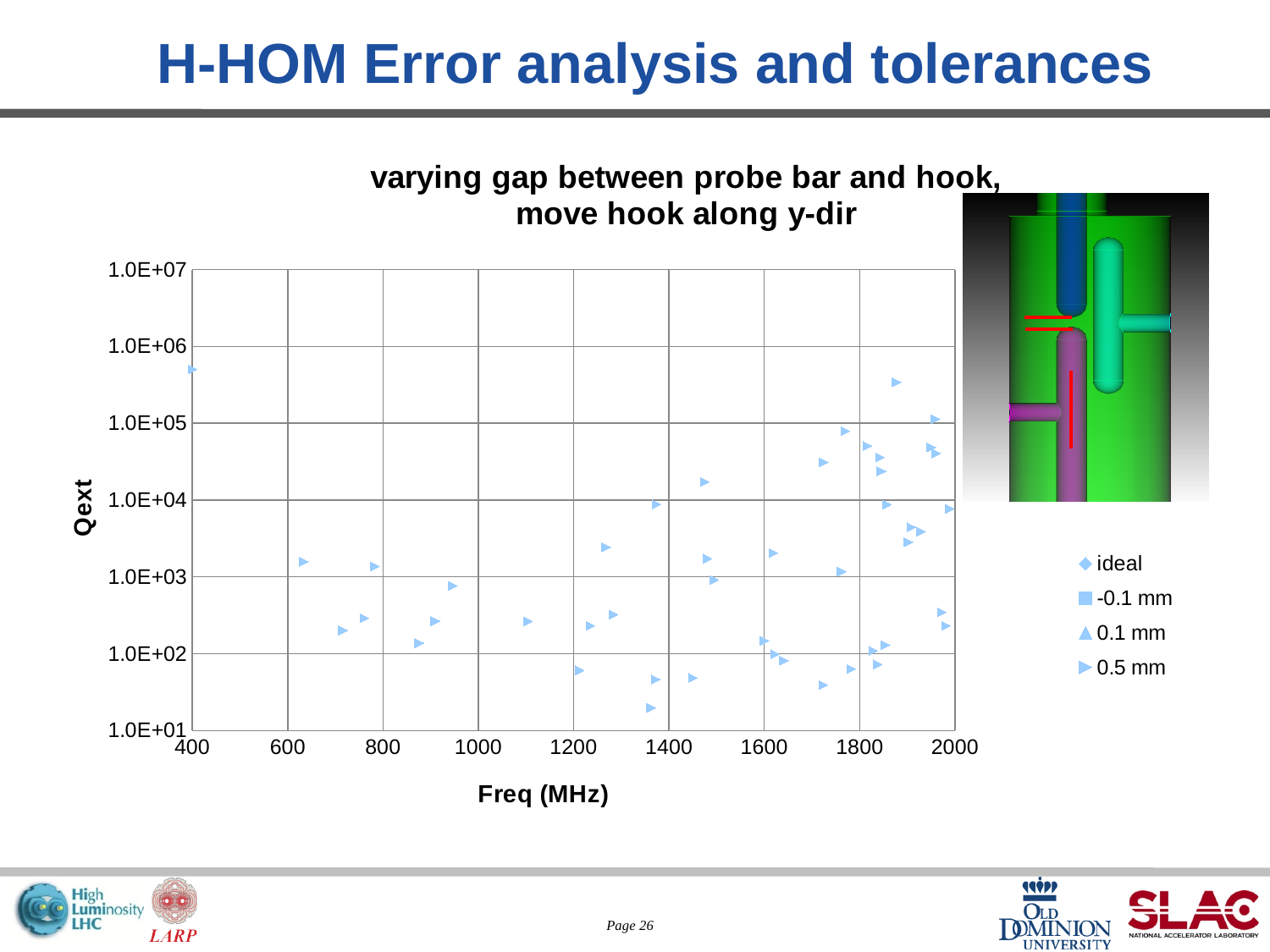
What is the title of the chart? varying gap between probe bar and hook, move hook along y-dir How many series does the chart legend list? 4 Is the highest plotted Qext value on the chart greater or less than 1.0E+06? less Is the lowest plotted Qext value on the chart greater or less than 1.0E+02? less Is the Qext value of the point plotted at 400 MHz greater or less than 1.0E+05? greater Which is larger: the Qext of the point at 400 MHz or the Qext of the point near 630 MHz? the point at 400 MHz What kind of chart is shown on the slide? scatter chart What is the label of the chart's y axis? Qext